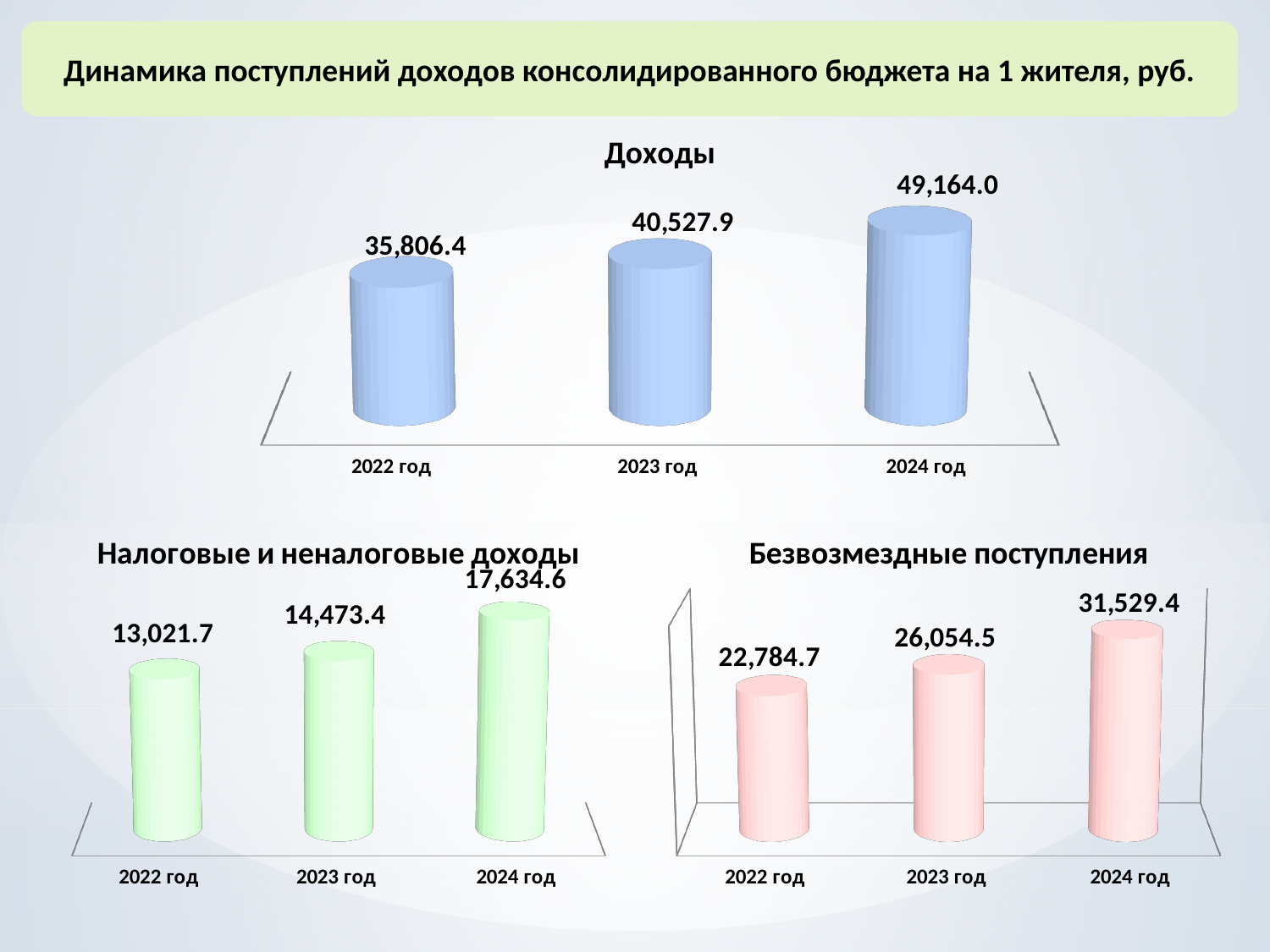
In the "Доходы" chart, which year has the highest value? 2024 год In the "Налоговые и неналоговые доходы" chart, which year has the lowest value? 2022 год In the "Безвозмездные поступления" chart, what is the difference between the 2023 год and 2022 год values? 3,269.8 Which is larger: the 2023 год value in the "Налоговые и неналоговые доходы" chart or the 2023 год value in the "Безвозмездные поступления" chart? Безвозмездные поступления In the "Безвозмездные поступления" chart, what is the value for 2024 год? 31,529.4 In the "Доходы" chart, what is the value for 2023 год? 40,527.9 What kind of chart is the "Безвозмездные поступления" chart? bar chart How many categories does the "Доходы" chart show? 3 In the "Безвозмездные поступления" chart, do the values rise or fall from 2022 год to 2024 год? rise In the "Налоговые и неналоговые доходы" chart, what is the difference between the 2024 год and 2023 год values? 3,161.2 In the "Налоговые и неналоговые доходы" chart, what is the value for 2022 год? 13,021.7 In the "Доходы" chart, what is the difference between the 2024 год and 2022 год values? 13,357.6